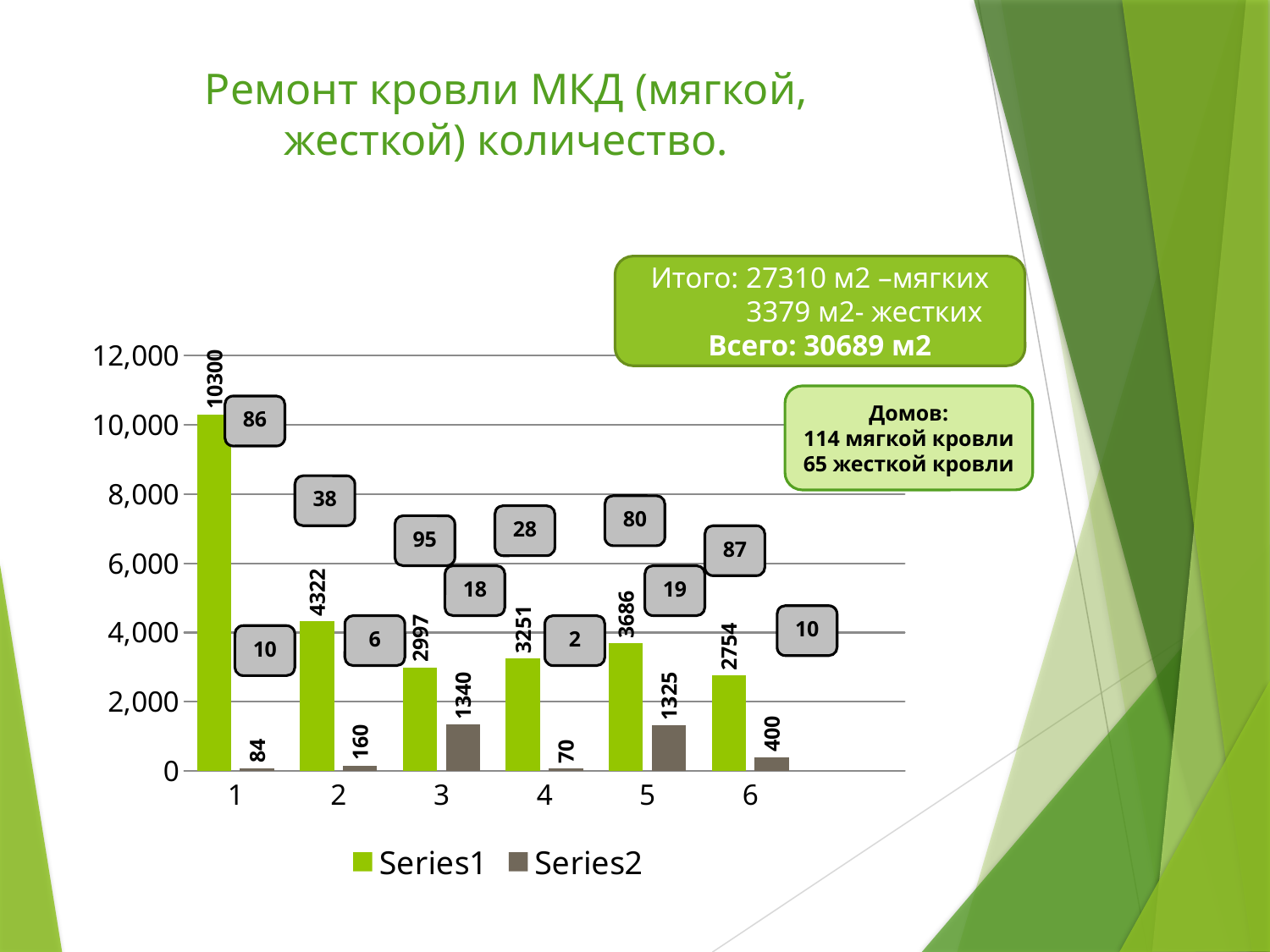
How many categories are shown on the x axis? 6 What type of chart is shown on the slide? bar chart What is the value of Series2 for category 3? 1340 Which is larger: the Series2 value for category 3 or for category 5? category 3 Is the Series1 value for category 5 greater or less than 4,000? less Which category has the lowest Series2 value? 4 What is the value of Series2 for category 4? 70 What is the value of Series1 for category 6? 2754 How many series does the legend list? 2 What is the difference between the Series1 values for category 2 and category 3? 1325 Which category has the highest Series1 value? 1 What is the value of Series1 for category 1? 10300